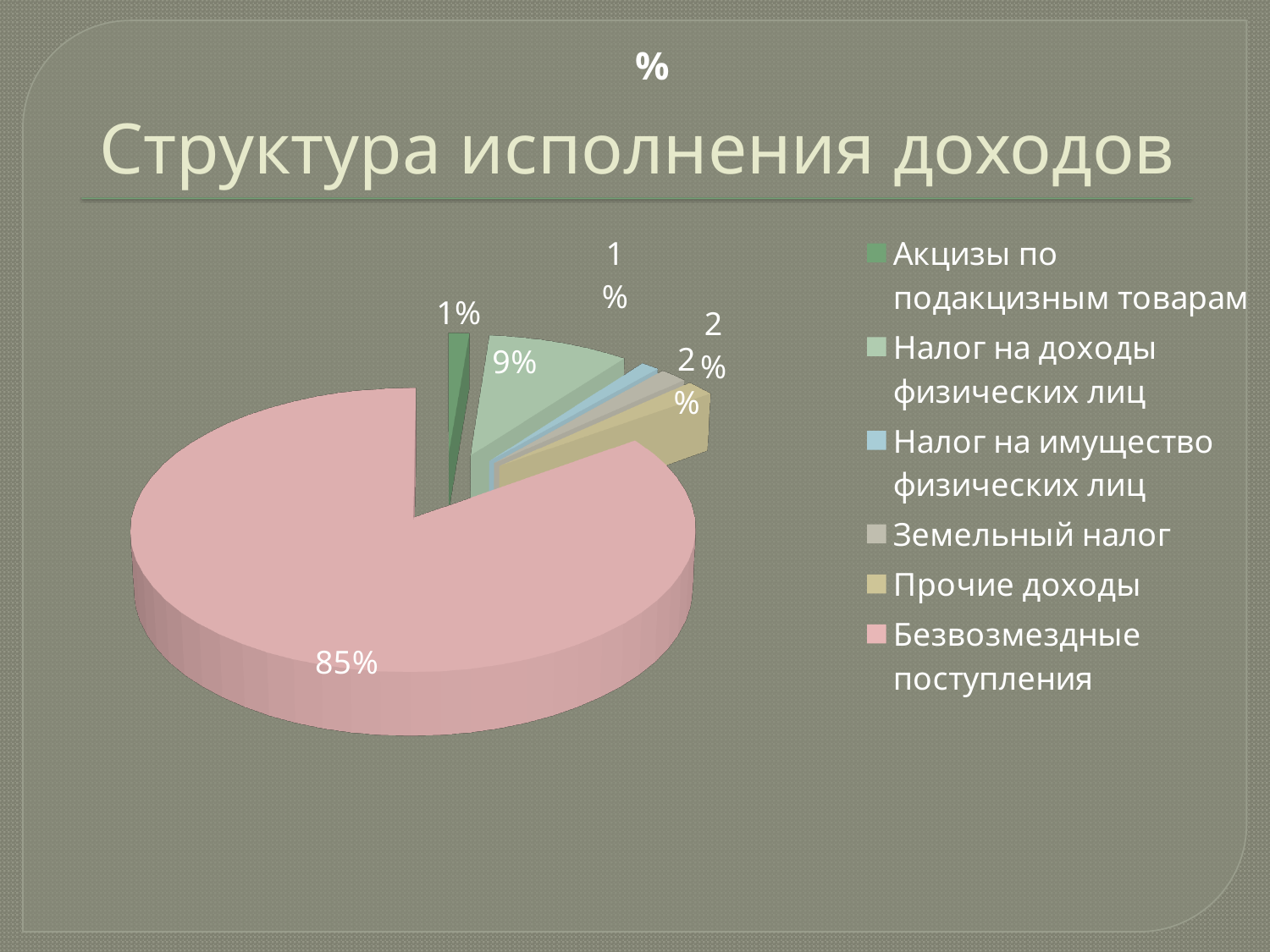
What kind of chart is shown on the slide? pie chart How many categories does the legend list? 6 What colour is the slice for Безвозмездные поступления? pink What is the value for Прочие доходы? 2% Which is larger, Налог на доходы физических лиц or Земельный налог? Налог на доходы физических лиц Which category has the largest share of the pie? Безвозмездные поступления What is the value for Акцизы по подакцизным товарам? 1% What is the difference between the shares of Безвозмездные поступления and Налог на доходы физических лиц? 76 percentage points What is the value for Земельный налог? 2% What is the value for Налог на доходы физических лиц? 9% What share of the pie is Безвозмездные поступления? 85% What is the title of the chart? %